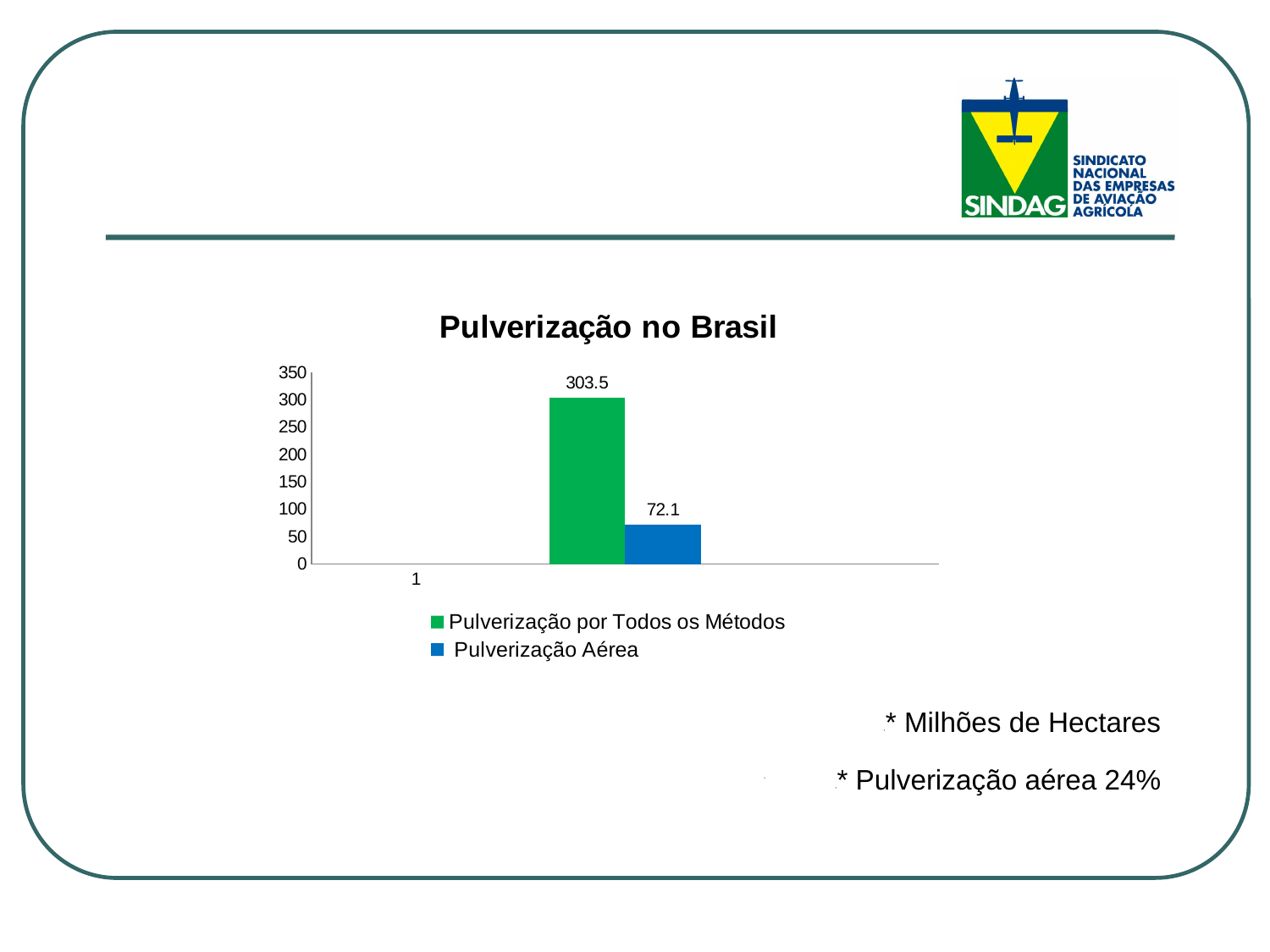
What is the value for Pulverização Aérea? 72.1 What is the title of the chart? Pulverização no Brasil What colour is the bar for Pulverização Aérea? blue What kind of chart is shown? bar chart Is the value for Pulverização por Todos os Métodos greater or less than 300? greater What is the highest value shown on the y axis? 350 What is the difference between the values for Pulverização por Todos os Métodos and Pulverização Aérea? 231.4 Which series has the lowest value? Pulverização Aérea Which series has the higher value, Pulverização por Todos os Métodos or Pulverização Aérea? Pulverização por Todos os Métodos Is the value for Pulverização Aérea greater or less than 100? less How many series does the legend list? 2 What is the value for Pulverização por Todos os Métodos? 303.5